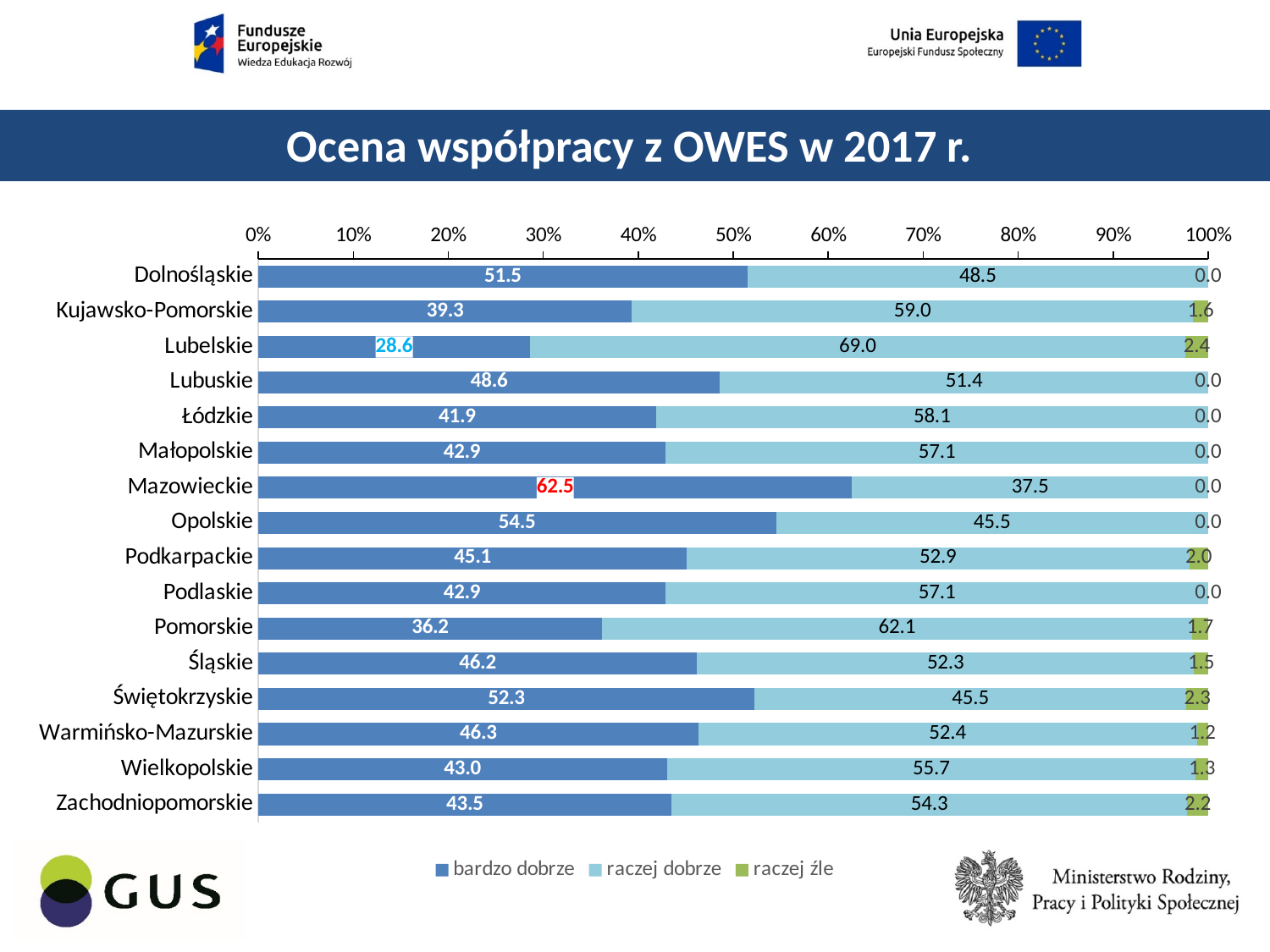
What is the difference between the 'bardzo dobrze' values for Dolnośląskie and Kujawsko-Pomorskie? 12.2 How many voivodeships are shown in the chart? 16 Which voivodeship has the highest 'raczej dobrze' value? Lubelskie Which has a larger 'bardzo dobrze' value, Opolskie or Świętokrzyskie? Opolskie What is the 'bardzo dobrze' value for Mazowieckie? 62.5 What is the 'raczej dobrze' value for Lubelskie? 69.0 What is the title of the chart? Ocena współpracy z OWES w 2017 r. Which voivodeship has the lowest 'bardzo dobrze' value? Lubelskie Which voivodeship has the highest 'bardzo dobrze' value? Mazowieckie How many series does the legend list? 3 What is the 'raczej źle' value for Lubelskie? 2.4 What kind of chart is shown on the slide? Stacked bar chart